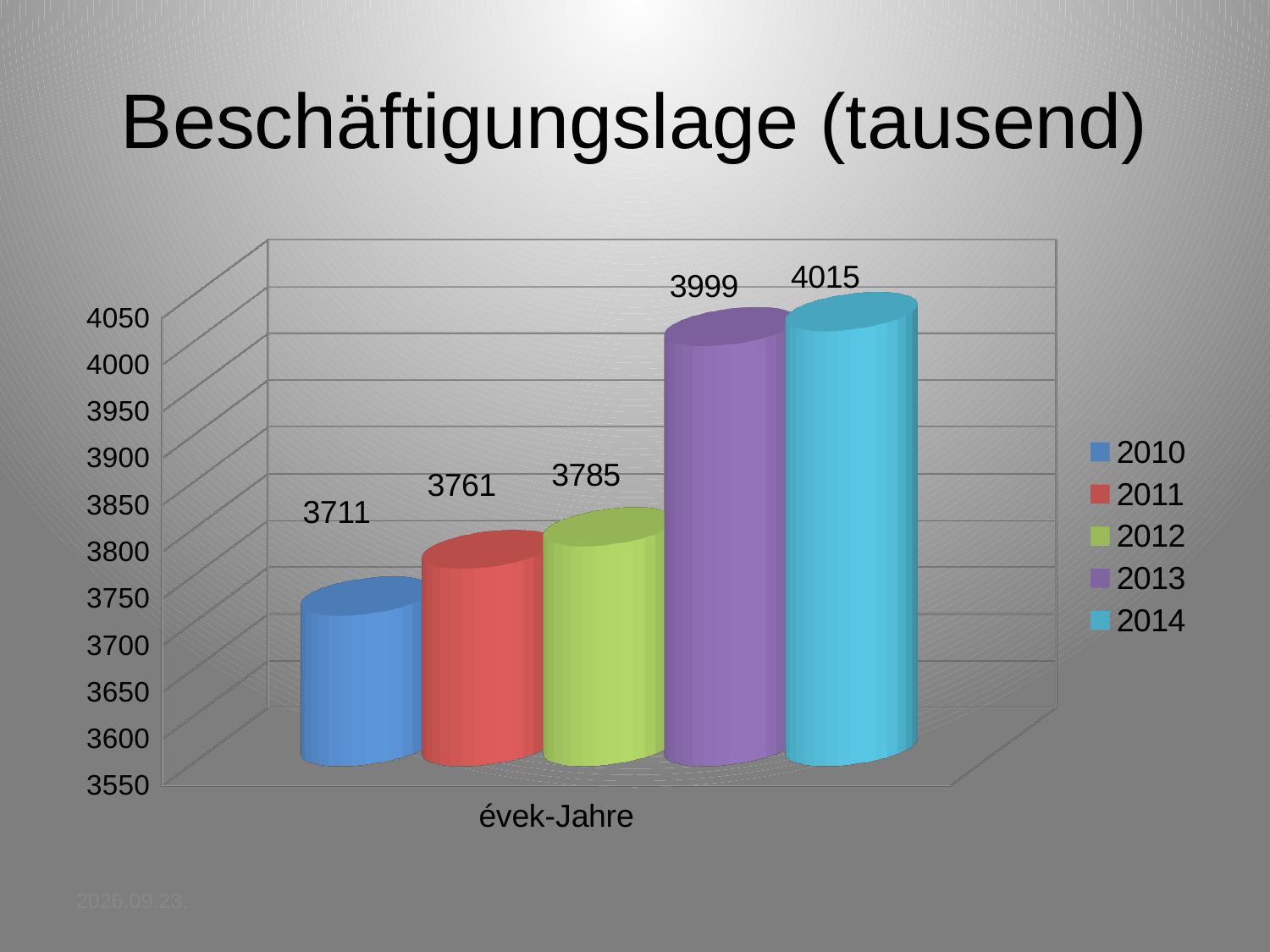
What is the difference between the values for 2011 and 2010? 50 What is the value for 2013? 3999 What is the value for 2010? 3711 Which year has the lowest value? 2010 What is the value for 2012? 3785 What is the title of the chart? Beschäftigungslage (tausend) Do the values rise or fall from 2010 to 2014? rise Which year has the highest value? 2014 What kind of chart is shown on the slide? bar chart Which is larger, the value for 2012 or the value for 2011? 2012 What is the difference between the values for 2014 and 2013? 16 How many series does the legend list? 5